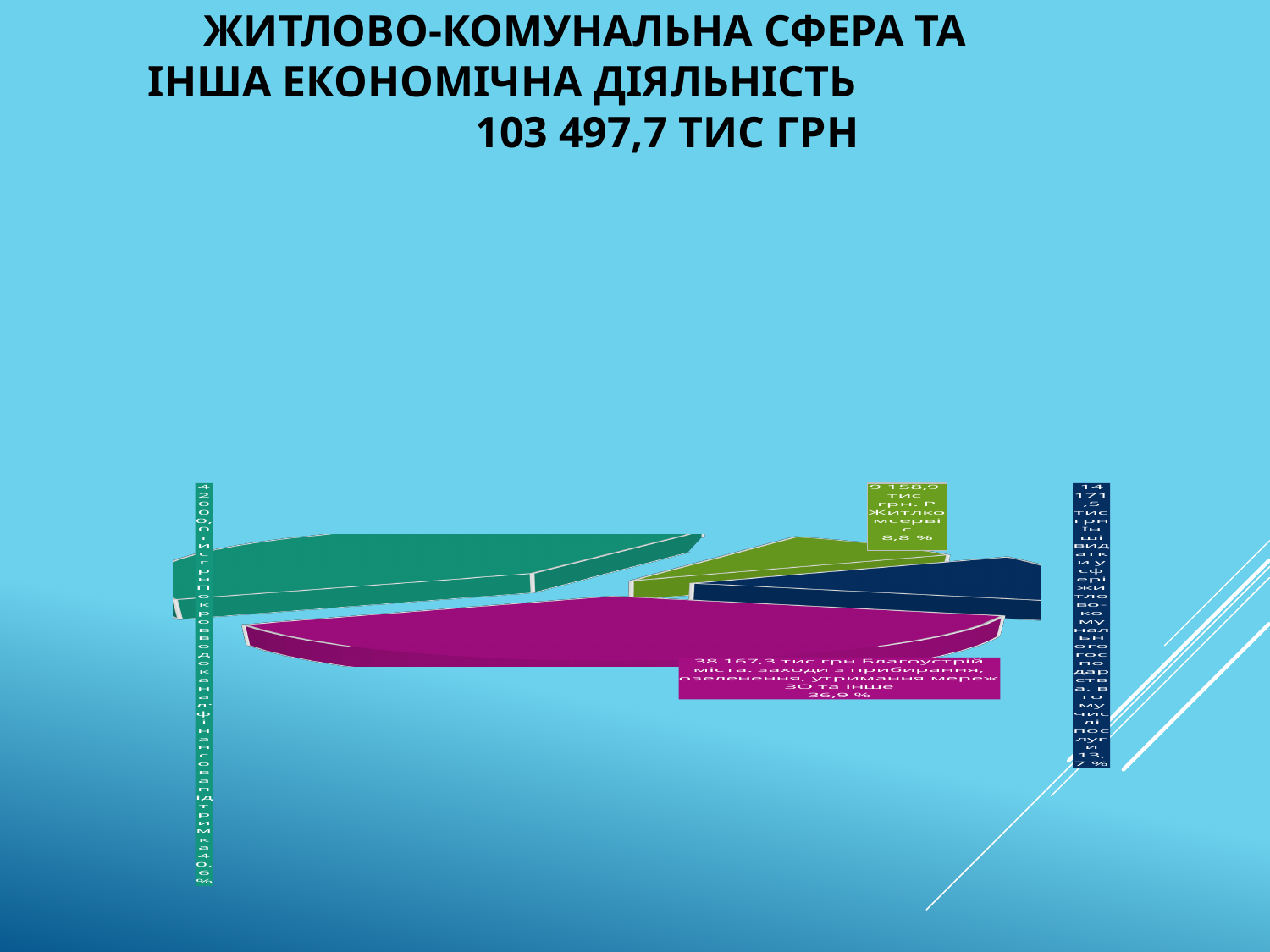
What kind of chart is shown on the slide? pie chart What total amount is stated in the slide title for the pie chart? 103 497,7 тис грн Which is larger: Інші видатки у сфері житлово-комунального господарства or Житлкомсервіс? Інші видатки у сфері житлово-комунального господарства What is the value for Житлкомсервіс in the pie chart? 9 158,9 тис грн What is the value for Інші видатки у сфері житлово-комунального господарства in the pie chart? 14 171,5 тис грн What share of the pie does Благоустрій міста represent? 36,9 % What is the value for Благоустрій міста in the pie chart? 38 167,3 тис грн How many slices does the pie chart have? 4 Which slice of the pie chart is the largest? Покровводоканал: фінансова підтримка Which slice of the pie chart is the smallest? Житлкомсервіс What is the difference between the values for Інші видатки у сфері житлово-комунального господарства and Житлкомсервіс? 5 012,6 тис грн What share of the pie does Покровводоканал: фінансова підтримка represent? 40,6 %